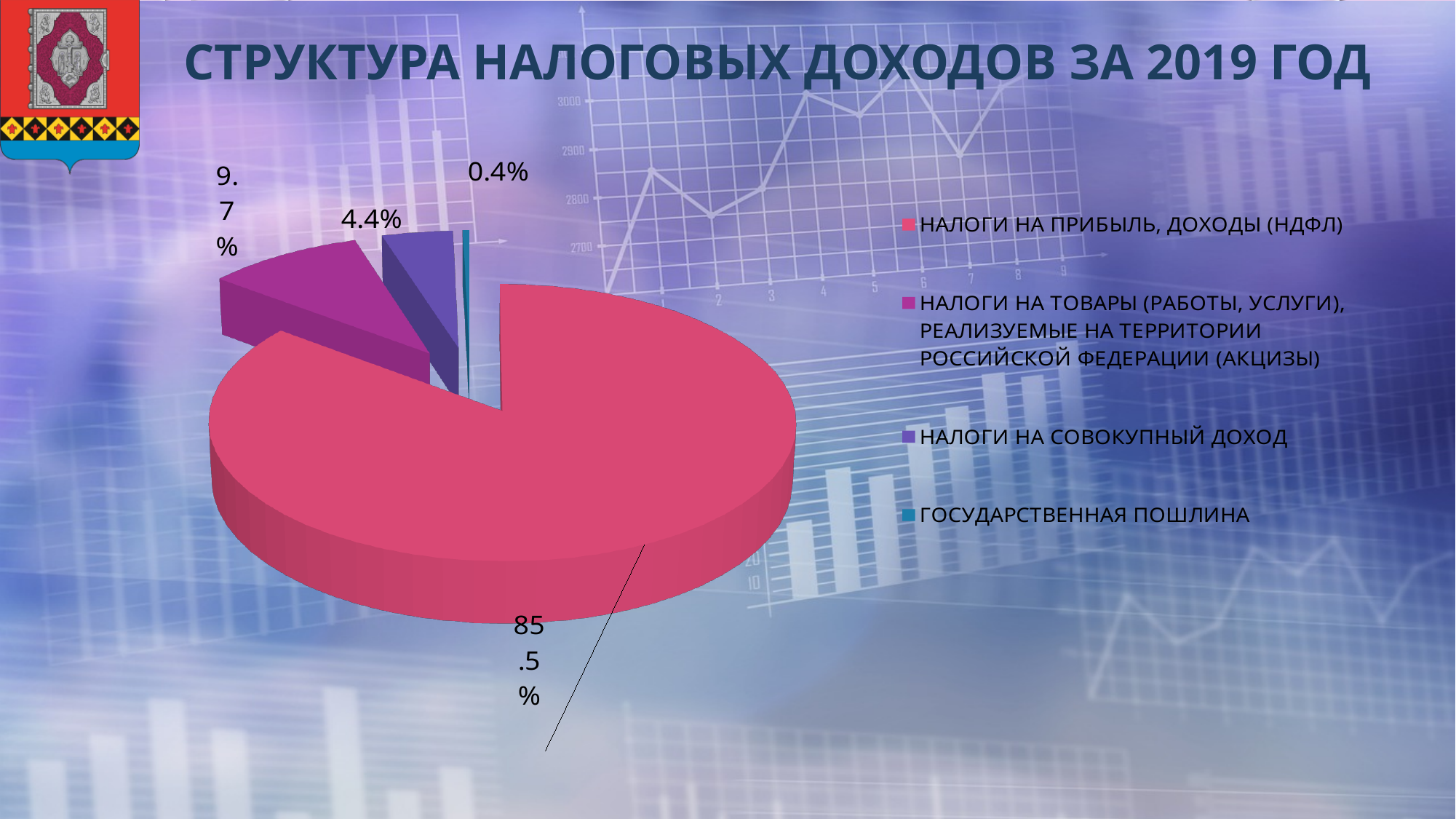
Which category has the largest slice of the pie? НАЛОГИ НА ПРИБЫЛЬ, ДОХОДЫ (НДФЛ) What kind of chart is shown on the slide? Pie chart What share of the pie does ГОСУДАРСТВЕННАЯ ПОШЛИНА have? 0.4% How many categories are shown in the pie chart? 4 Which category has the smallest slice of the pie? ГОСУДАРСТВЕННАЯ ПОШЛИНА What share of the pie does НАЛОГИ НА СОВОКУПНЫЙ ДОХОД have? 4.4% What share of the pie does НАЛОГИ НА ТОВАРЫ (РАБОТЫ, УСЛУГИ), РЕАЛИЗУЕМЫЕ НА ТЕРРИТОРИИ РОССИЙСКОЙ ФЕДЕРАЦИИ (АКЦИЗЫ) have? 9.7% What is the title of the chart on the slide? СТРУКТУРА НАЛОГОВЫХ ДОХОДОВ ЗА 2019 ГОД What is the difference in percentage points between the НДФЛ slice and the АКЦИЗЫ slice? 75.8 Which is larger: the share for НАЛОГИ НА СОВОКУПНЫЙ ДОХОД or the share for АКЦИЗЫ? АКЦИЗЫ What is the difference in percentage points between the НАЛОГИ НА СОВОКУПНЫЙ ДОХОД slice and the ГОСУДАРСТВЕННАЯ ПОШЛИНА slice? 4.0